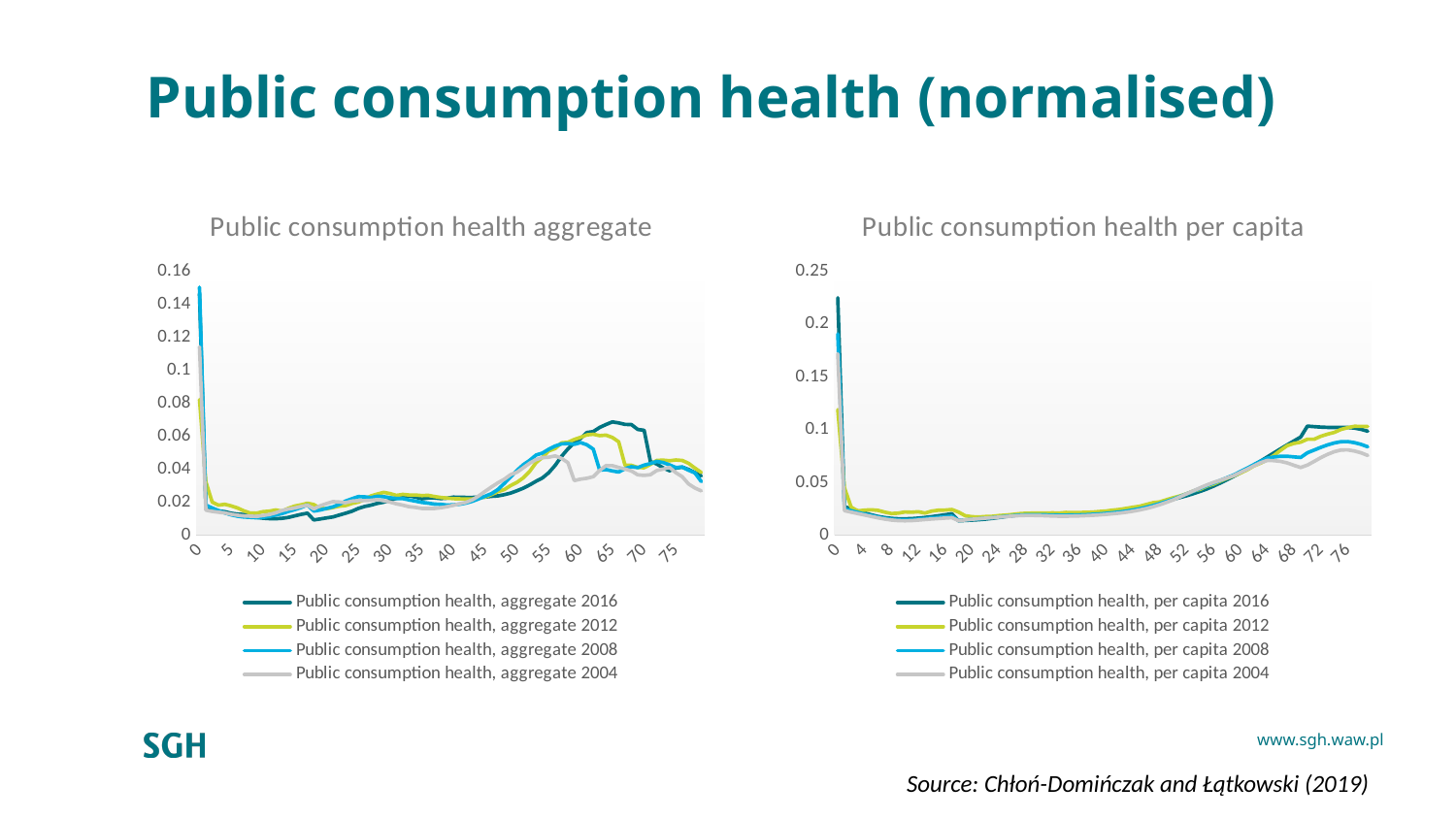
In the 'Public consumption health aggregate' chart, is the value for aggregate 2016 at age 0 greater or less than 0.1? greater In the 'Public consumption health per capita' chart, is the value for per capita 2012 at age 0 greater or less than 0.15? less In the 'Public consumption health aggregate' chart, is the value for aggregate 2016 at age 65 greater or less than 0.04? greater How many series does the legend of the 'Public consumption health aggregate' chart list? 4 In the 'Public consumption health per capita' chart, which series has the highest value at age 0? Public consumption health, per capita 2016 In the 'Public consumption health per capita' chart, which series has the lowest value at age 0? Public consumption health, per capita 2012 In the 'Public consumption health per capita' chart, which is larger at age 72: per capita 2016 or per capita 2004? Public consumption health, per capita 2016 In the 'Public consumption health per capita' chart, do the values for per capita 2016 rise or fall between age 40 and age 68? Rise What kind of chart is the 'Public consumption health aggregate' chart on the left? Line chart What is the title of the chart on the right of the slide? Public consumption health per capita How many series does the legend of the 'Public consumption health per capita' chart list? 4